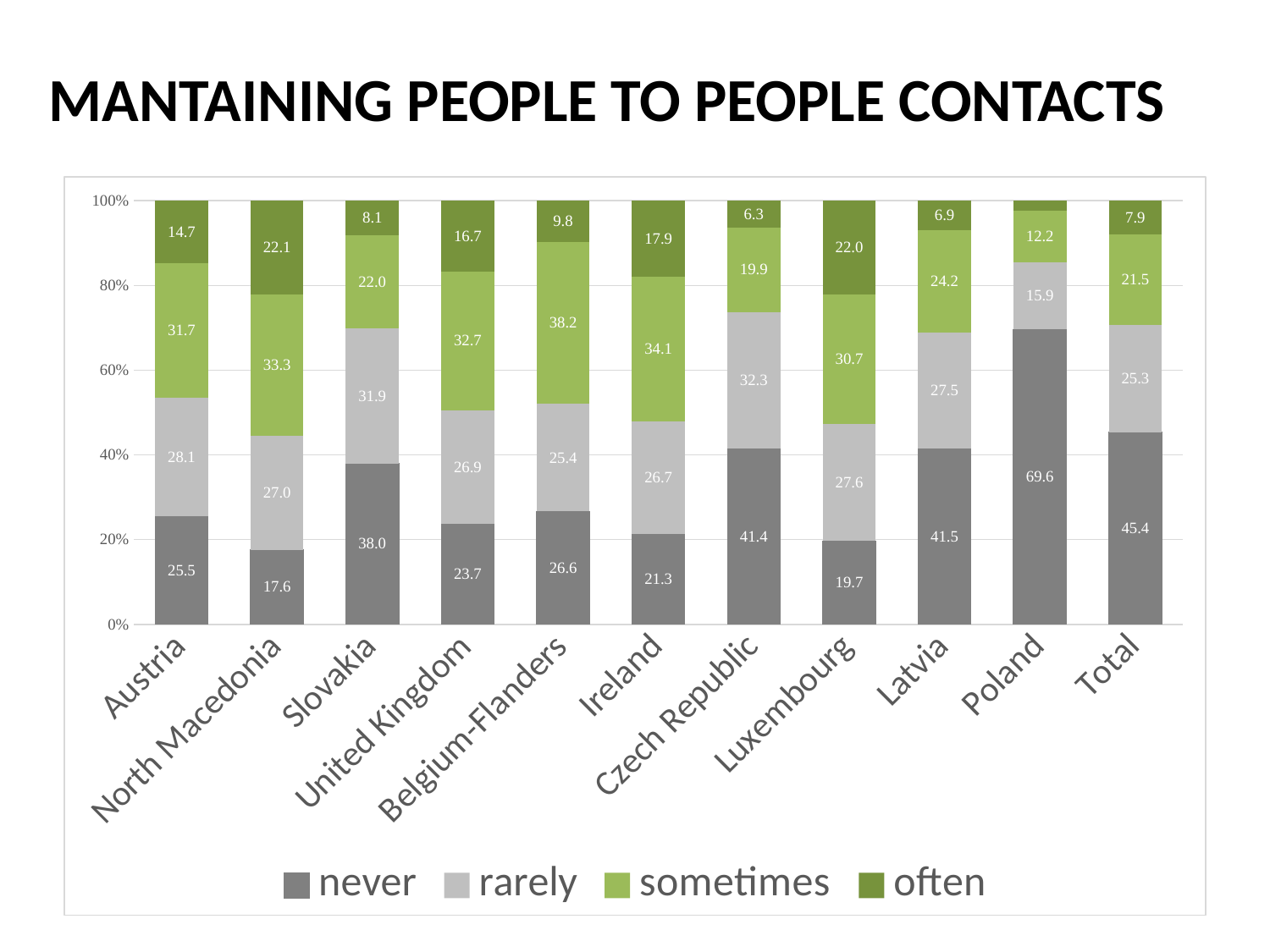
What is the "rarely" value for the Total bar? 25.3 What is the "often" value for North Macedonia? 22.1 What kind of chart is shown on the slide? Stacked bar chart Which category has the highest "sometimes" value? Belgium-Flanders What is the "sometimes" value for Belgium-Flanders? 38.2 Which country has the lowest "never" value? North Macedonia How many series does the legend list? 4 Which is larger, the "never" value for Slovakia or the "never" value for Latvia? Latvia What is the difference between the "never" value for Poland and the "never" value for Total? 24.2 How many categories are shown on the x axis? 11 Which country has the highest "never" value? Poland What percentage of respondents in Poland answered "never"? 69.6